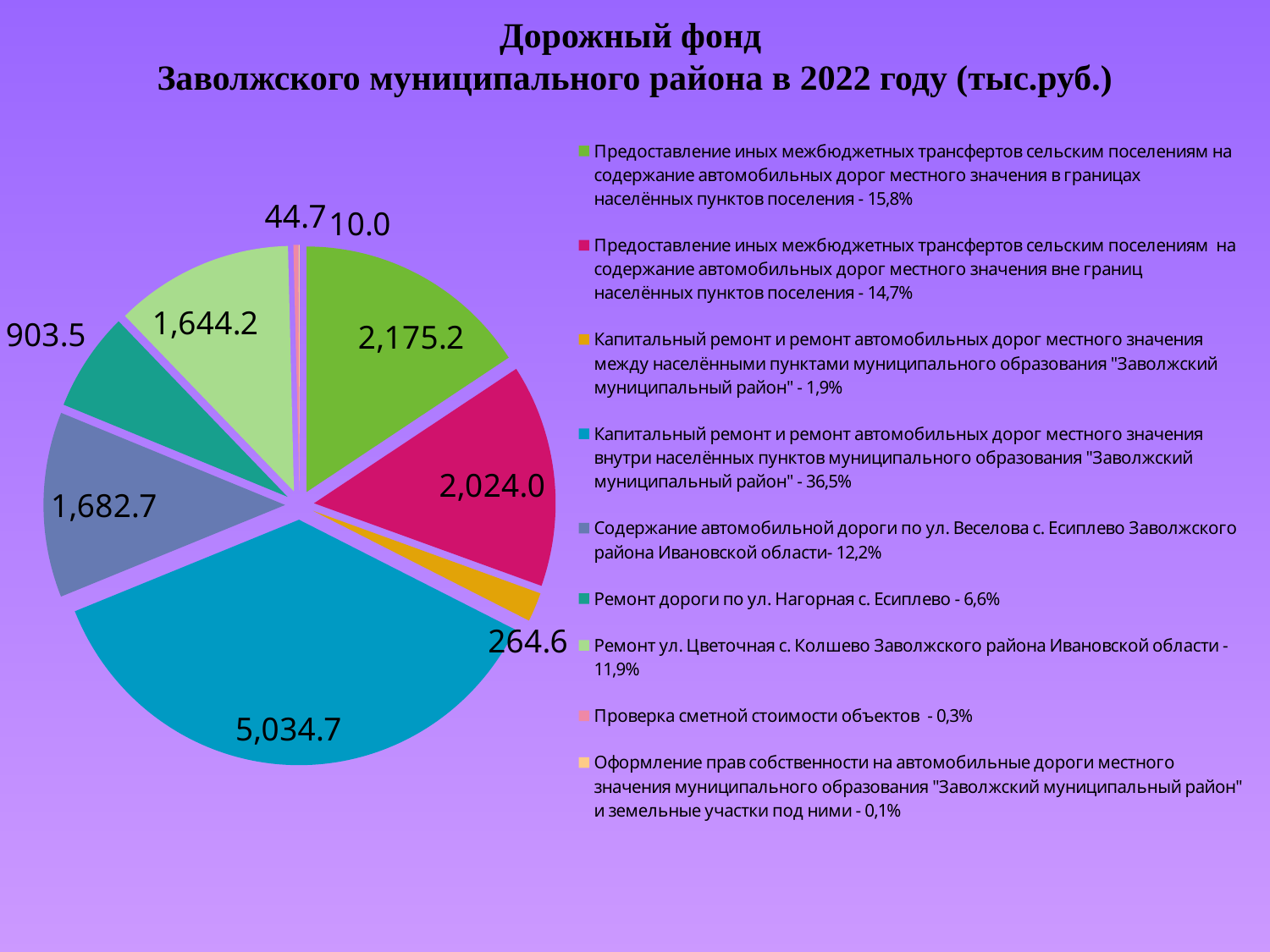
How many entries does the legend list? 9 Which category has the smallest slice in the pie chart? Оформление прав собственности на автомобильные дороги местного значения муниципального образования "Заволжский муниципальный район" и земельные участки под ними What is the value of the slice for "Содержание автомобильной дороги по ул. Веселова с. Есиплево Заволжского района Ивановской области"? 1,682.7 What share of the pie does "Проверка сметной стоимости объектов" represent, according to the legend? 0,3% Which category has the largest slice in the pie chart? Капитальный ремонт и ремонт автомобильных дорог местного значения внутри населённых пунктов муниципального образования "Заволжский муниципальный район" How many slices does the pie chart have? 9 What is the difference between the slice labelled 2,175.2 and the slice labelled 2,024.0? 151.2 What is the value of the slice for "Ремонт дороги по ул. Нагорная с. Есиплево"? 903.5 What is the value of the slice for "Капитальный ремонт и ремонт автомобильных дорог местного значения внутри населённых пунктов муниципального образования "Заволжский муниципальный район""? 5,034.7 What type of chart is shown on the slide? pie chart Which is larger: the slice for "Ремонт ул. Цветочная с. Колшево Заволжского района Ивановской области" or the slice for "Ремонт дороги по ул. Нагорная с. Есиплево"? Ремонт ул. Цветочная с. Колшево Заволжского района Ивановской области What is the title of the chart on the slide? Дорожный фонд Заволжского муниципального района в 2022 году (тыс.руб.)